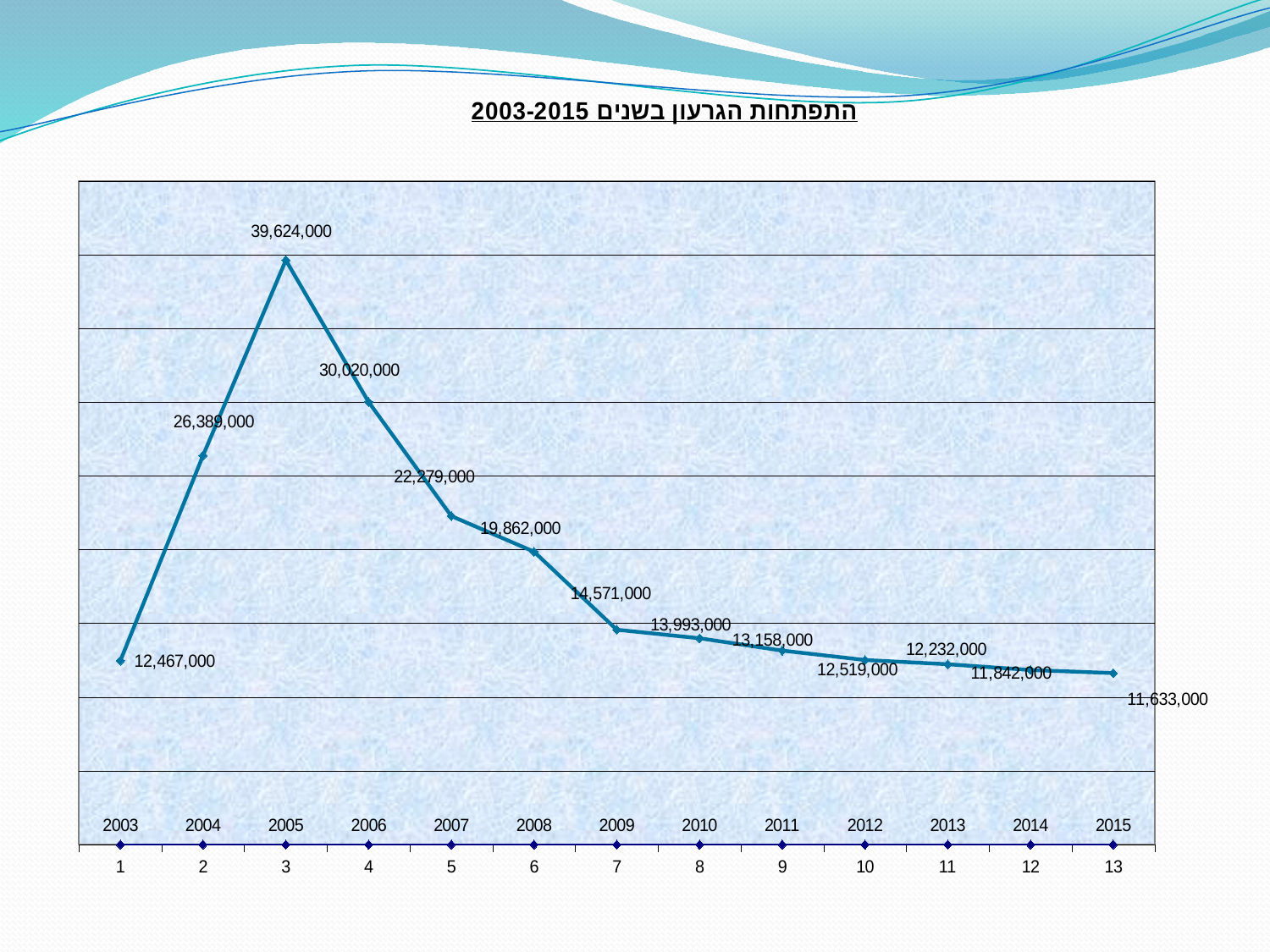
What type of chart is shown on the slide? line chart What is the value plotted for 2005? 39,624,000 Do the values rise or fall from 2005 to 2015? fall Which year has the lowest value? 2015 What is the value plotted for 2009? 14,571,000 What is the difference between the values for 2005 and 2006? 9,604,000 How many years are plotted on the chart? 13 What is the difference between the values for 2003 and 2004? 13,922,000 Which year has the highest value? 2005 What is the value plotted for 2003? 12,467,000 Which is larger, the value for 2007 or the value for 2008? 2007 What is the value plotted for 2015? 11,633,000